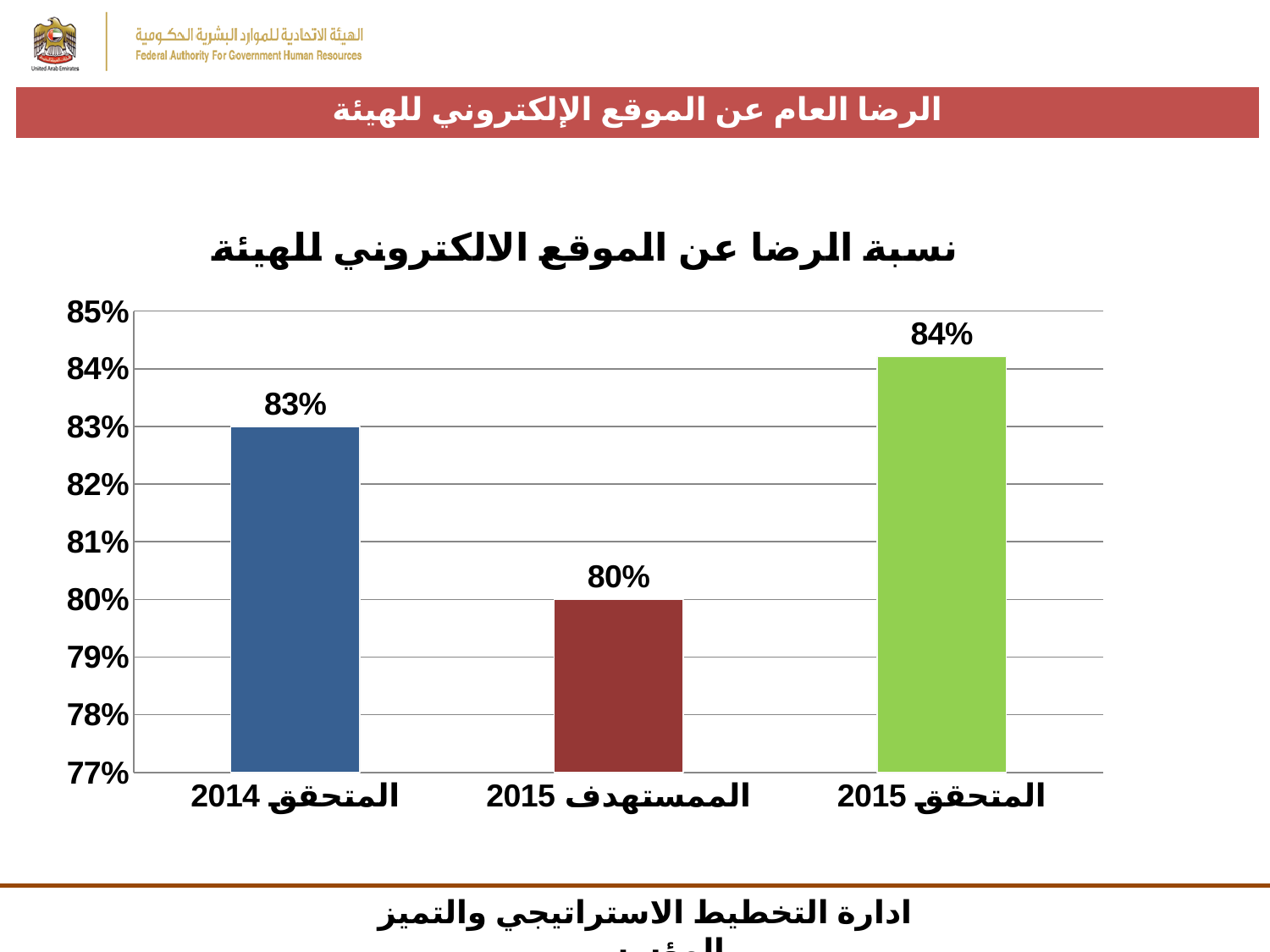
How many categories are shown in the chart? 3 What is the difference between the values for المتحقق 2015 and المتحقق 2014? 1% Which category has the lowest value? المستهدف 2015 What is the difference between the values for المتحقق 2015 and المستهدف 2015? 4% What is the value for المتحقق 2014? 83% What is the value for المستهدف 2015? 80% What kind of chart is shown on the slide? bar chart What is the value for المتحقق 2015? 84% Which is larger, the value for المتحقق 2014 or the value for المستهدف 2015? المتحقق 2014 Which category has the highest value? المتحقق 2015 Is the value for المستهدف 2015 greater or less than 82%? less What is the title of the chart? نسبة الرضا عن الموقع الالكتروني للهيئة